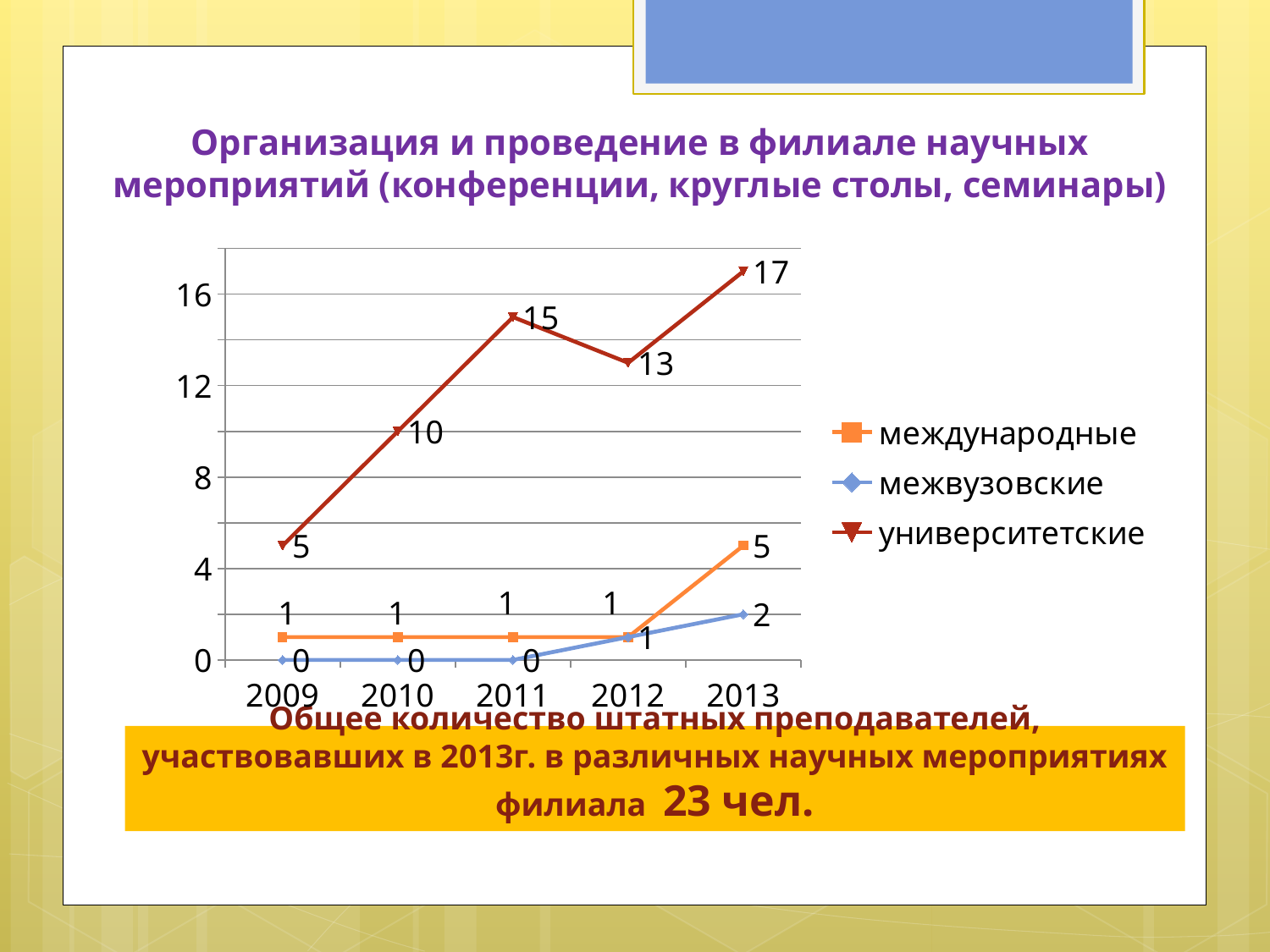
Which series has the larger value in 2013, международные or межвузовские? международные What is the value for университетские in 2011? 15 What kind of chart is shown on the slide? line chart How many years are shown on the x axis? 5 What is the value for международные in 2013? 5 What is the difference between the университетские values in 2013 and 2012? 4 How many series does the legend list? 3 In which year is the value for университетские highest? 2013 What is the value for межвузовские in 2012? 1 Is the value for университетские in 2010 greater or less than 8? greater In which year is the value for университетские lowest? 2009 Which series is drawn in dark red? университетские